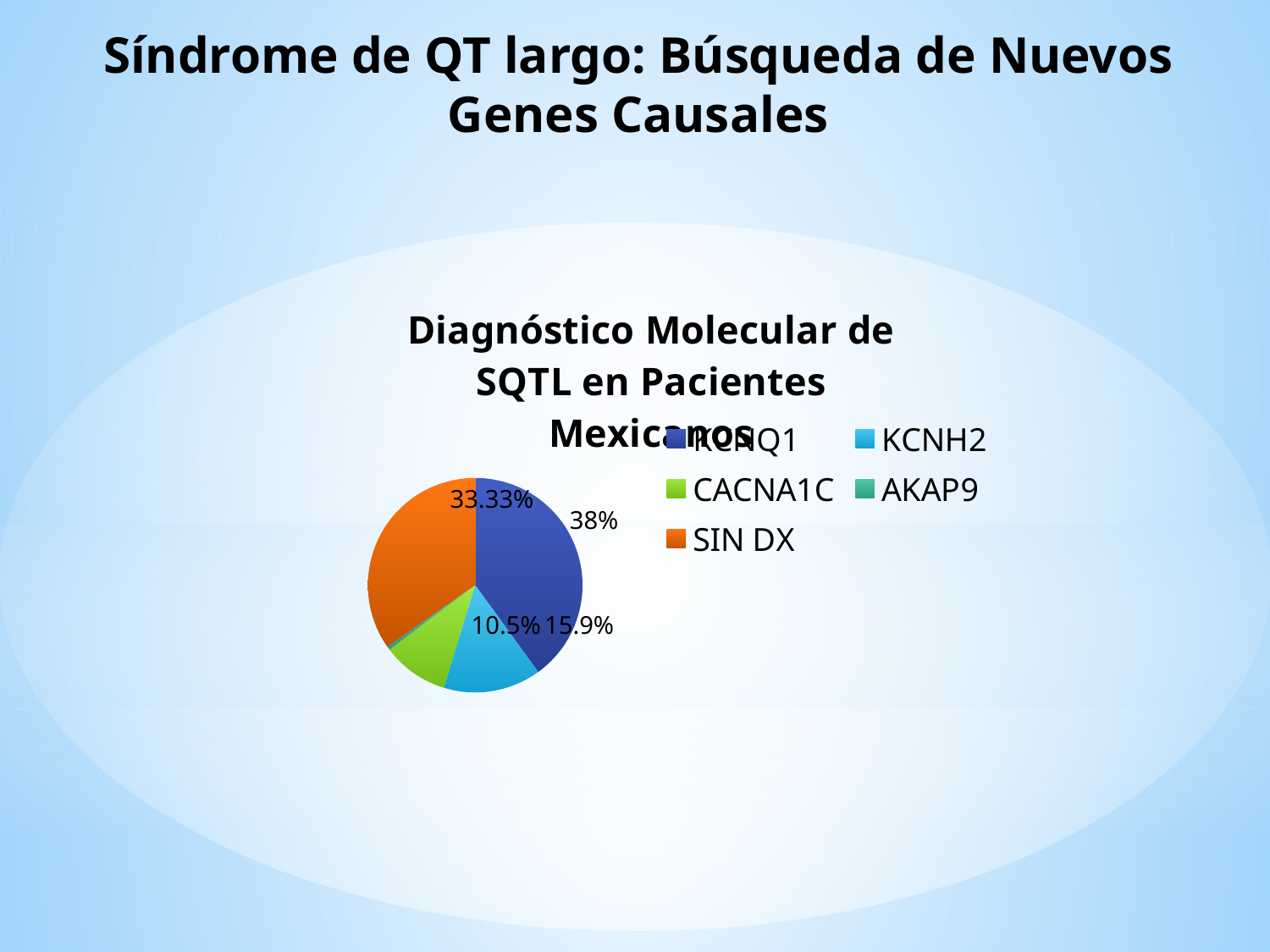
Which category has the largest share of the pie? KCNQ1 What is the title of the chart? Diagnóstico Molecular de SQTL en Pacientes Mexicanos What percentage of the pie corresponds to KCNQ1? 38% What colour is the SIN DX slice in the pie chart? orange What type of chart is shown on the slide? pie chart Which is larger, the share for KCNQ1 or the share for SIN DX? KCNQ1 What percentage of the pie corresponds to SIN DX? 33.33% What is the difference in percentage points between the KCNQ1 share and the SIN DX share? 4.67% Which category has the smallest share of the pie? AKAP9 How many categories does the legend of the pie chart list? 5 Which slice is larger, KCNH2 or CACNA1C? KCNH2